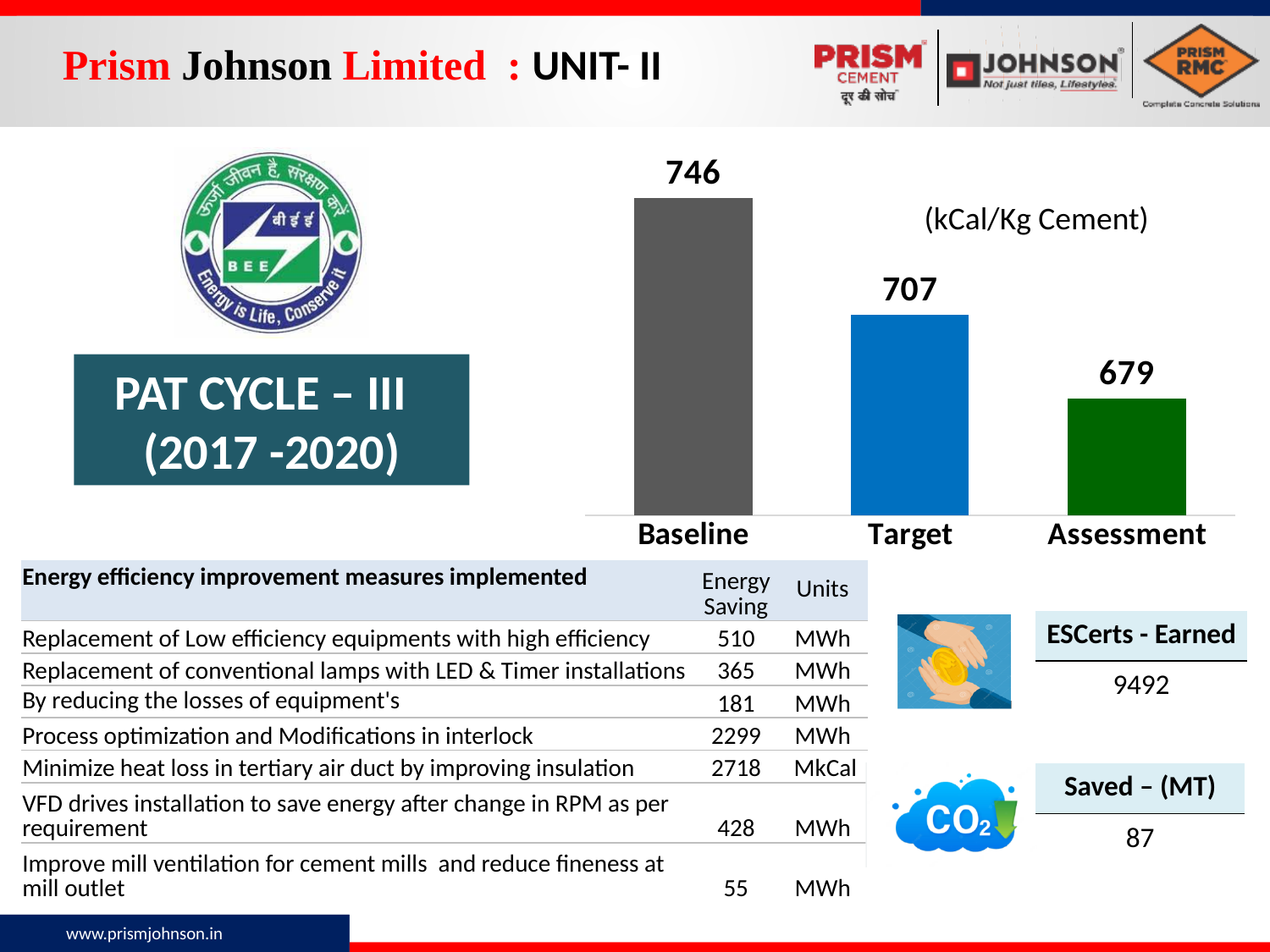
Which category has the highest value in the chart? Baseline Which category has the lowest value in the chart? Assessment What type of chart is shown on the slide? Bar chart Which is larger, the Target value or the Assessment value? Target What is the difference between the Baseline and Assessment values? 67 What is the value of the Assessment bar in the chart? 679 What is the value of the Target bar in the chart? 707 Do the values rise or fall from Baseline to Assessment? Fall How many bars are shown in the chart? 3 What unit is shown next to the chart? kCal/Kg Cement What is the value of the Baseline bar in the chart? 746 What is the difference between the Target and Assessment values? 28